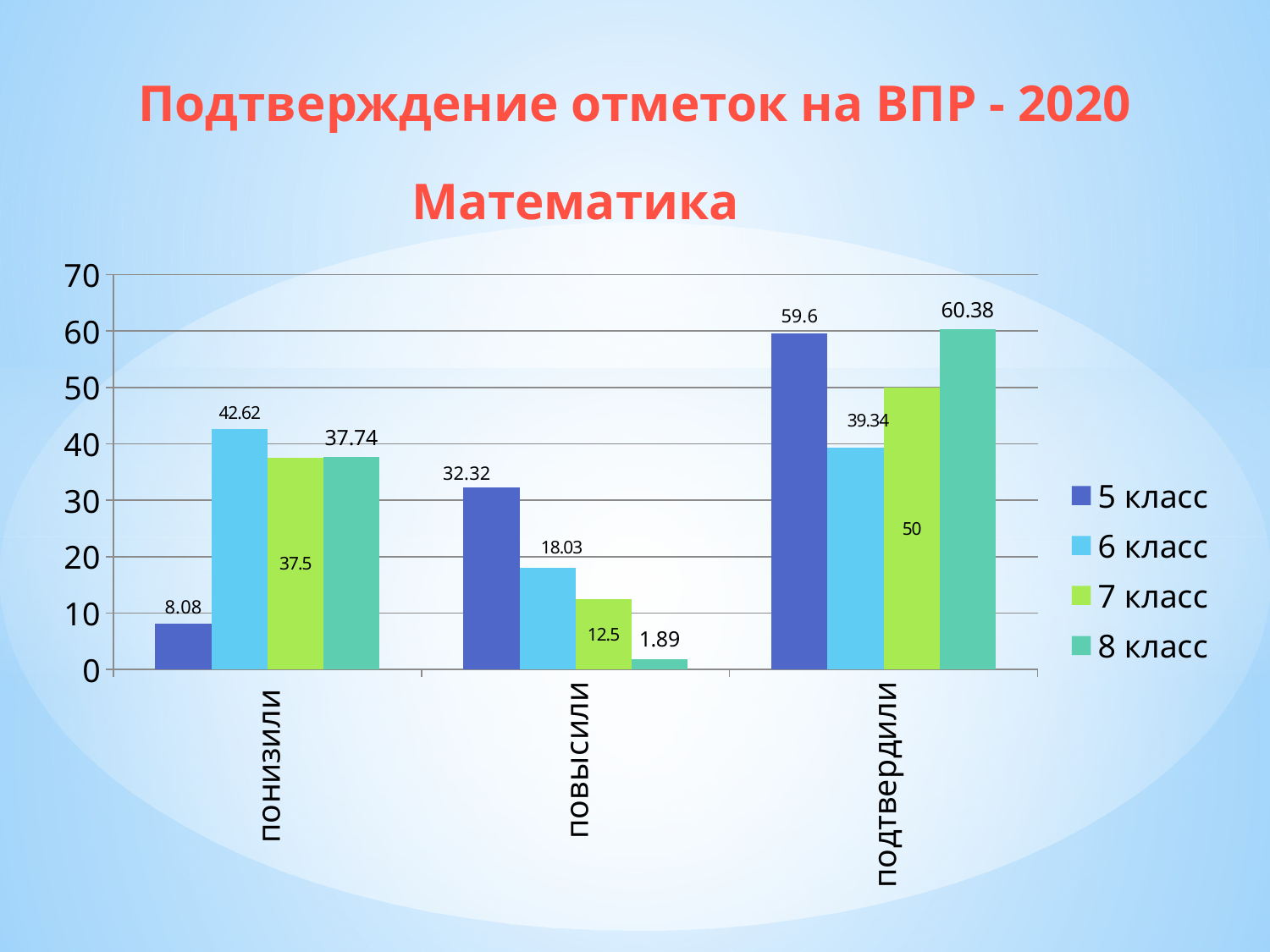
How many categories are shown on the x axis? 3 Is the value for 7 класс in the подтвердили category greater or less than 40? greater Which is larger in the подтвердили category: the value for 5 класс or for 6 класс? 5 класс Which class has the highest value in the понизили category? 6 класс What is the value for 7 класс in the повысили category? 12.5 What is the difference between the 5 класс and 6 класс values in the повысили category? 14.29 How many series does the legend list? 4 What is the value for 5 класс in the понизили category? 8.08 What type of chart is shown on the slide? bar chart What is the subject named in the chart title? Математика What is the value for 8 класс in the подтвердили category? 60.38 Which class has the lowest value in the повысили category? 8 класс